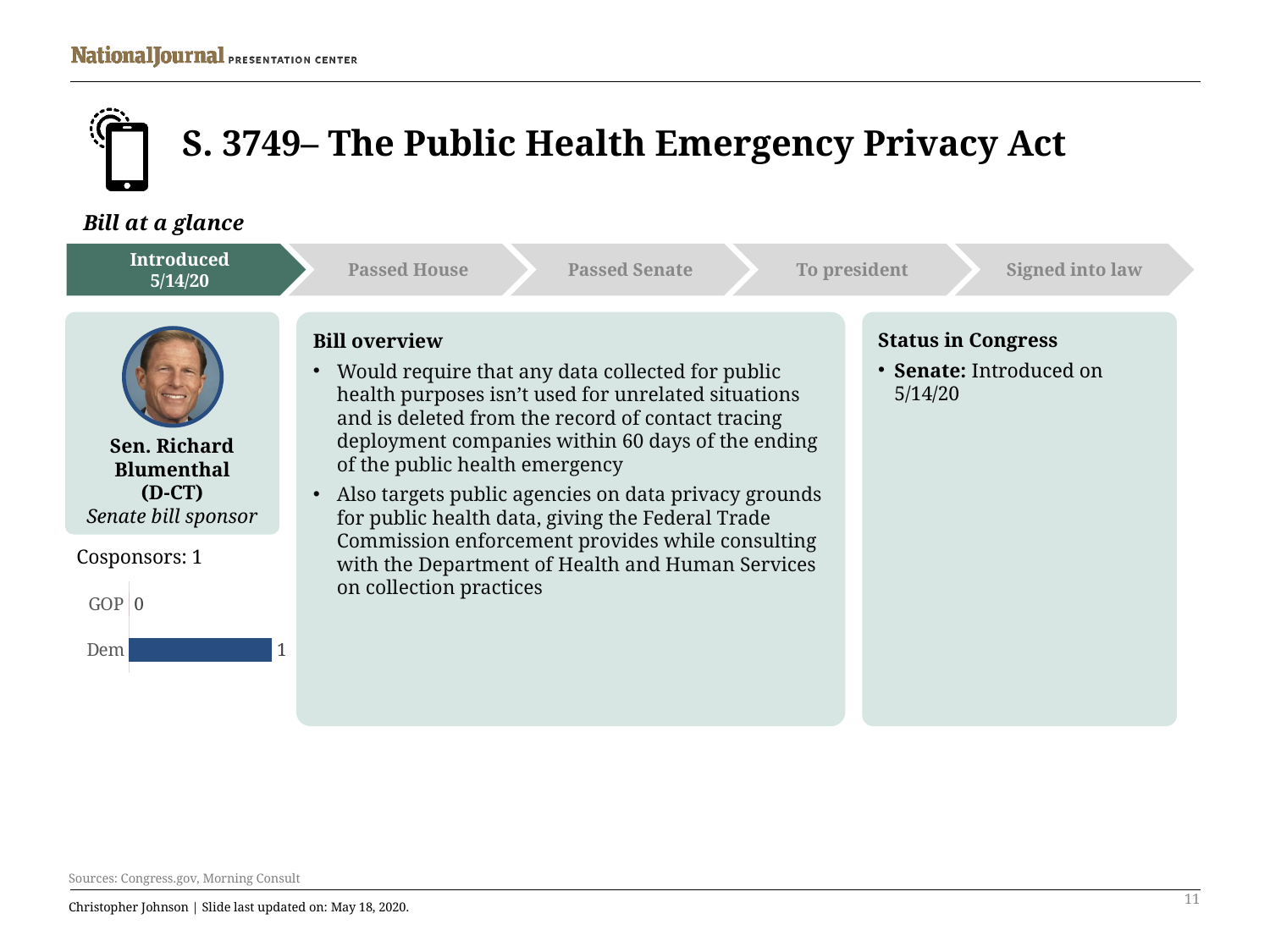
How many categories are shown in the cosponsors bar chart? 2 What is the difference between the Dem and GOP cosponsor counts in the bar chart? 1 What colour is the Dem bar in the cosponsors chart? blue Which party has the lower number of cosponsors in the bar chart? GOP What is the number of Dem cosponsors shown in the cosponsors bar chart? 1 What is the total number of cosponsors shown above the bar chart? 1 What kind of chart is used to show the cosponsors by party? bar chart Which party has the higher number of cosponsors in the bar chart? Dem Is the Dem cosponsor value larger or smaller than the GOP cosponsor value? larger What is the number of GOP cosponsors shown in the cosponsors bar chart? 0